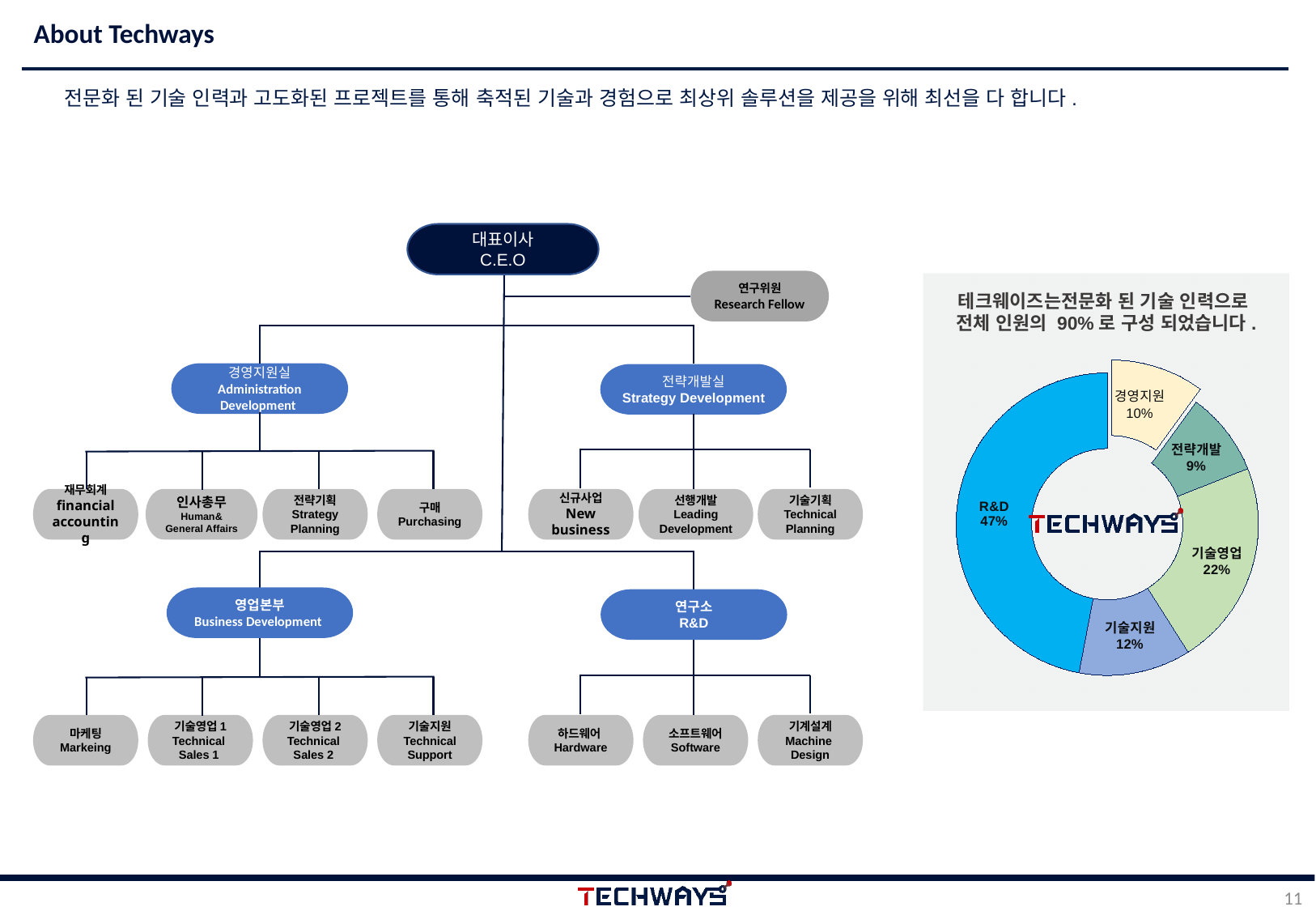
What percentage is labelled for 경영지원 in the donut chart? 10% What share of the donut chart is R&D? 47% How many segments does the donut chart have? 5 Which is larger in the donut chart, 기술지원 or 경영지원? 기술지원 What is the value shown for 기술지원 in the donut chart? 12% What type of chart is shown on the right side of the slide? Donut chart Which segment of the donut chart is the largest? R&D By how many percentage points does R&D exceed 기술영업 in the donut chart? 25 What is the value for 전략개발 in the donut chart? 9% What is the combined share of 기술영업 and 기술지원 in the donut chart? 34% What percentage does the 기술영업 slice represent in the donut chart? 22% Which segment of the donut chart is the smallest? 전략개발